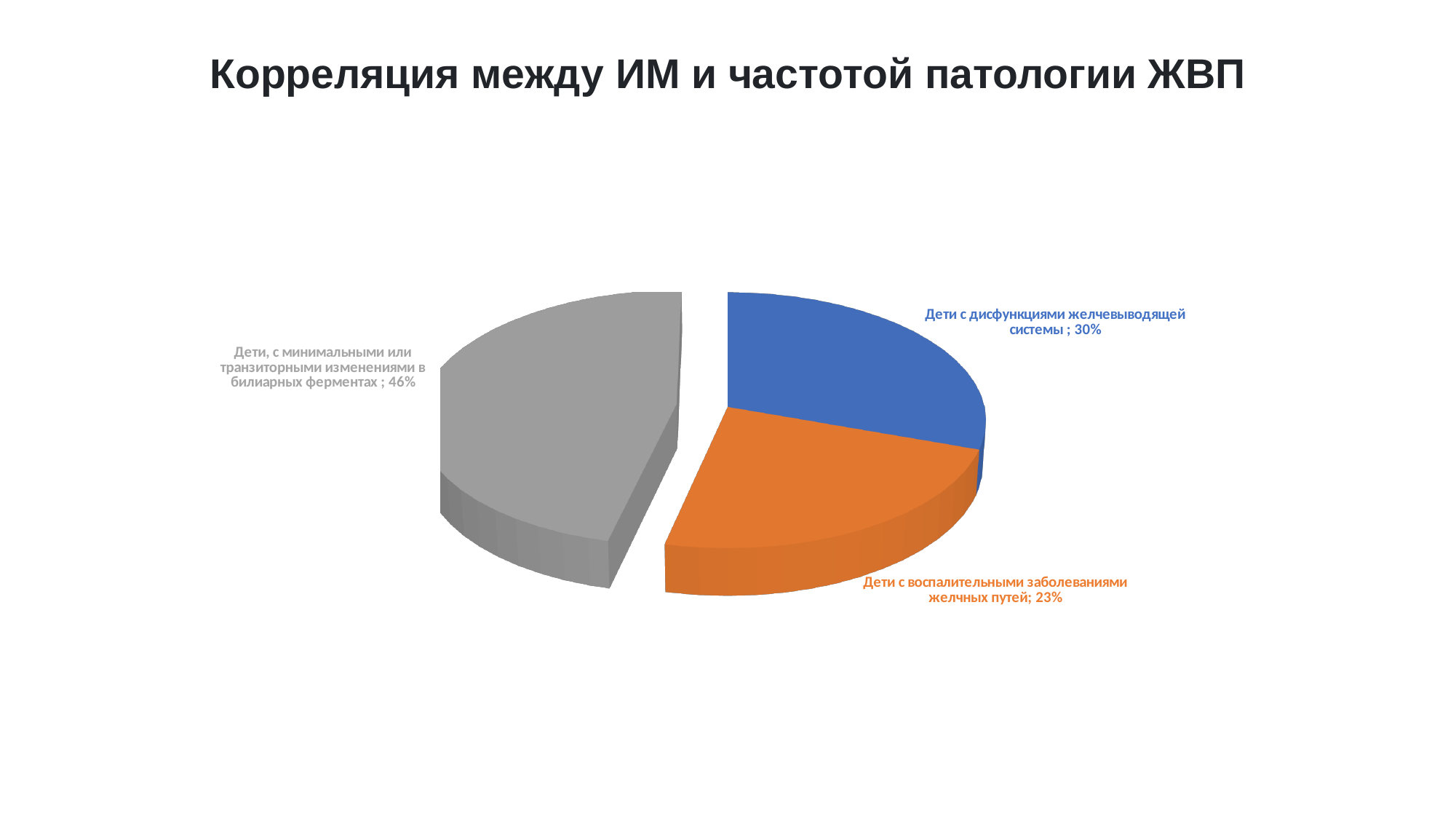
What share of the pie is labelled 'Дети с воспалительными заболеваниями желчных путей'? 23% What share of the pie is labelled 'Дети с дисфункциями желчевыводящей системы'? 30% What is the title of the chart? Корреляция между ИМ и частотой патологии ЖВП Which category has the largest share of the pie? Дети, с минимальными или транзиторными изменениями в билиарных ферментах Which category has the smallest share of the pie? Дети с воспалительными заболеваниями желчных путей What colour is the slice for 'Дети с воспалительными заболеваниями желчных путей'? Orange How many slices does the pie chart have? 3 What is the difference in percentage points between the share for 'Дети с дисфункциями желчевыводящей системы' and the share for 'Дети с воспалительными заболеваниями желчных путей'? 7 What kind of chart is shown on the slide? Pie chart What share of the pie is labelled 'Дети, с минимальными или транзиторными изменениями в билиарных ферментах'? 46% Which is larger: the share for 'Дети с дисфункциями желчевыводящей системы' or the share for 'Дети с воспалительными заболеваниями желчных путей'? Дети с дисфункциями желчевыводящей системы What is the difference in percentage points between the share for 'Дети, с минимальными или транзиторными изменениями в билиарных ферментах' and the share for 'Дети с дисфункциями желчевыводящей системы'? 16